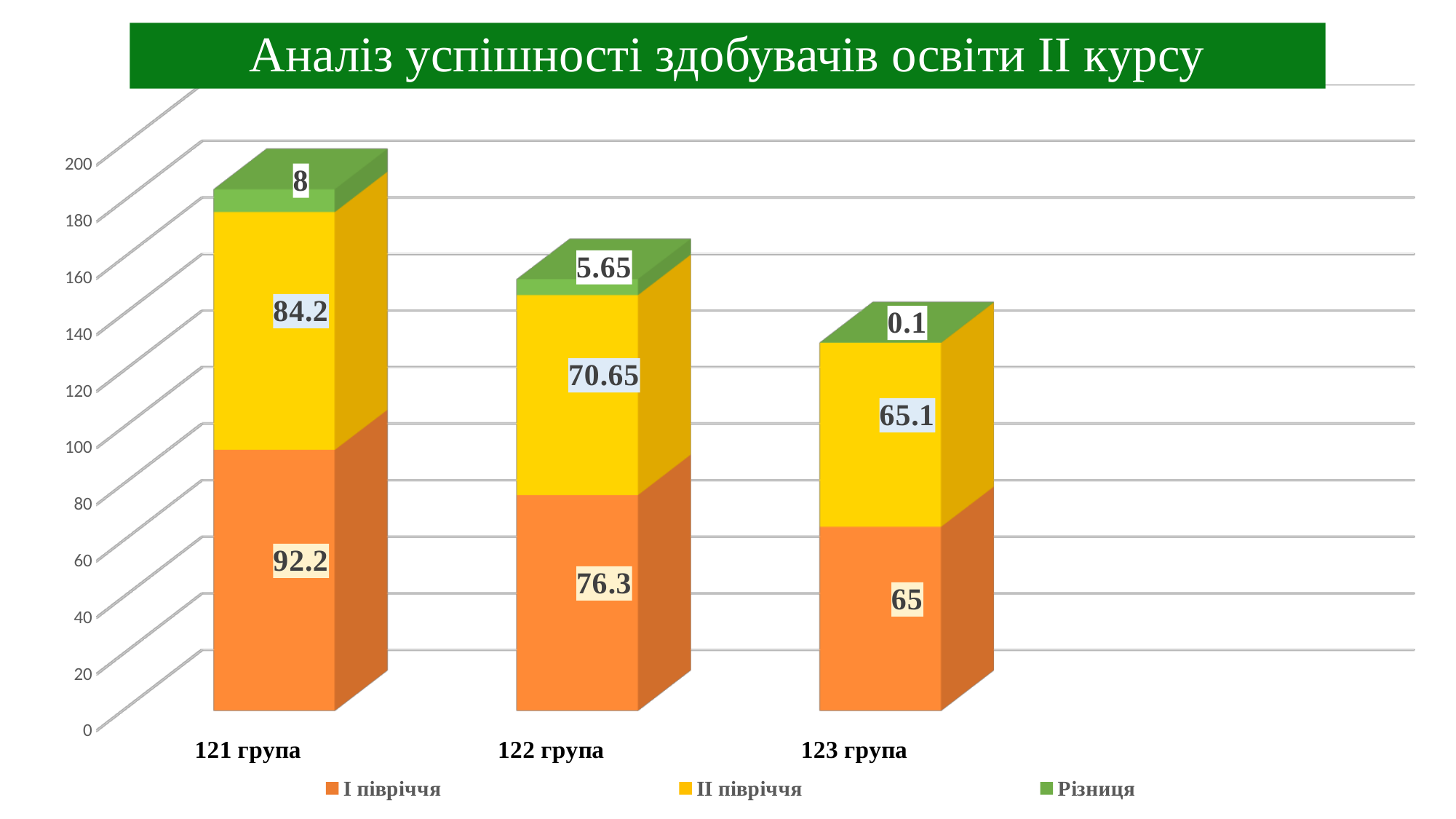
What is the title of the chart? Аналіз успішності здобувачів освіти ІІ курсу What is the value of I півріччя for 121 група? 92.2 What is the value of II півріччя for 122 група? 70.65 Which group has the highest value for I півріччя? 121 група What is the value of Різниця for 123 група? 0.1 What type of chart is shown on the slide? bar chart What is the total of the stacked bar for 121 група? 184.4 How many series does the legend list? 3 Which group has the lowest value for Різниця? 123 група How many groups are shown on the x axis? 3 What is the difference between the I півріччя values for 121 група and 122 група? 15.9 Which is larger: the II півріччя value for 122 група or for 123 група? 122 група